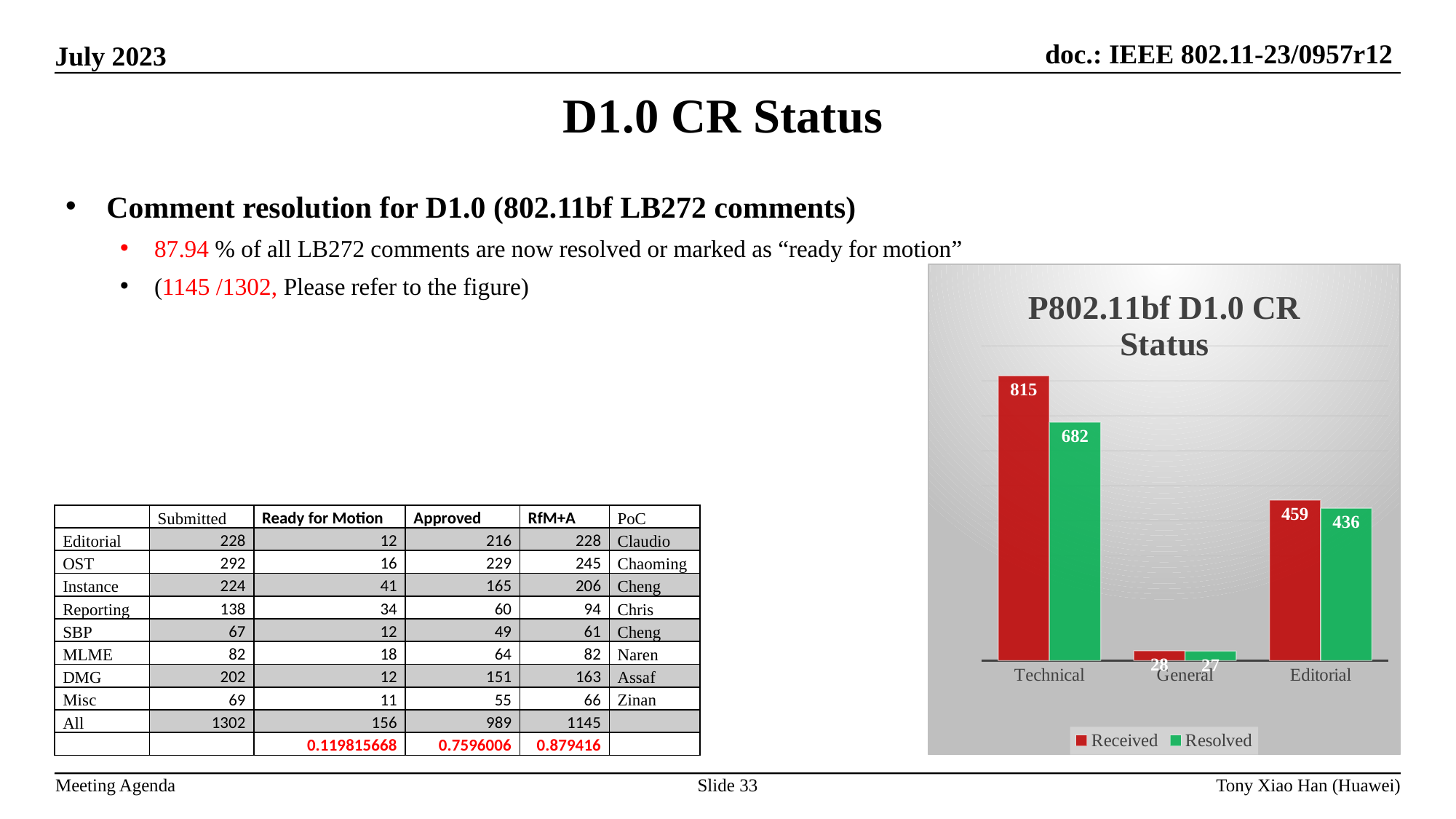
In the P802.11bf D1.0 CR Status chart, is the Resolved value for Technical larger or smaller than the Received value for Editorial? larger How many categories are shown on the x axis of the P802.11bf D1.0 CR Status chart? 3 What is the Resolved value for Editorial in the P802.11bf D1.0 CR Status chart? 436 What is the Received value for Technical in the P802.11bf D1.0 CR Status chart? 815 In the P802.11bf D1.0 CR Status chart, what is the difference between Received and Resolved for Editorial? 23 Which category has the highest Received value in the P802.11bf D1.0 CR Status chart? Technical What is the Resolved value for General in the P802.11bf D1.0 CR Status chart? 27 Which colour represents the Resolved series in the P802.11bf D1.0 CR Status chart? green How many series does the legend of the P802.11bf D1.0 CR Status chart list? 2 Which category has the lowest Resolved value in the P802.11bf D1.0 CR Status chart? General In the P802.11bf D1.0 CR Status chart, what is the difference between Received and Resolved for Technical? 133 What type of chart is the P802.11bf D1.0 CR Status chart? bar chart